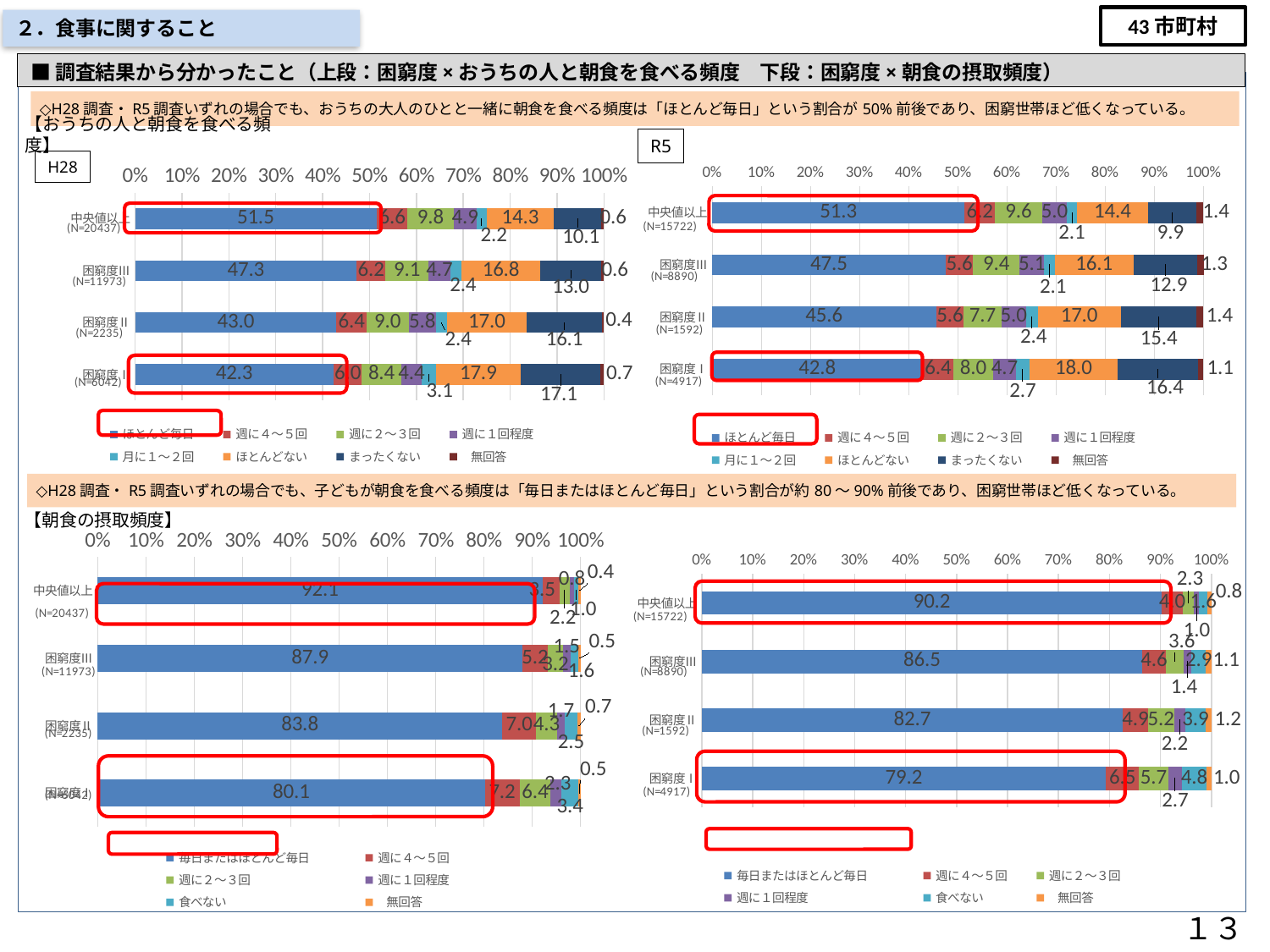
How many categories are shown on the y axis of the top-left H28 chart (おうちの人と朝食を食べる頻度)? 4 In the top-left H28 chart (おうちの人と朝食を食べる頻度), what is the value of ほとんど毎日 for 中央値以上? 51.5 In the bottom-left H28 chart (朝食の摂取頻度), which is larger: the 毎日またはほとんど毎日 value for 困窮度Ⅱ or for 困窮度Ⅰ? 困窮度Ⅱ In the top-right R5 chart (おうちの人と朝食を食べる頻度), what is the value of ほとんど毎日 for 困窮度Ⅰ? 42.8 In the bottom-right R5 chart (朝食の摂取頻度), which category has the lowest value for 毎日またはほとんど毎日? 困窮度Ⅰ In the top-right R5 chart (おうちの人と朝食を食べる頻度), what is the value of ほとんどない for 困窮度Ⅰ? 18.0 How many series does the legend of the top-right R5 chart (おうちの人と朝食を食べる頻度) list? 8 In the top-left H28 chart (おうちの人と朝食を食べる頻度), which category has the highest value for まったくない? 困窮度Ⅰ In the top-right R5 chart (おうちの人と朝食を食べる頻度), what is the difference between the ほとんど毎日 values for 中央値以上 and 困窮度Ⅰ? 8.5 What kind of chart is the bottom-right R5 chart (朝食の摂取頻度)? Stacked bar chart In the bottom-left H28 chart (朝食の摂取頻度), what is the value of 毎日またはほとんど毎日 for 困窮度Ⅲ? 87.9 In the bottom-right R5 chart (朝食の摂取頻度), is the 毎日またはほとんど毎日 value for 中央値以上 greater or less than 80%? greater